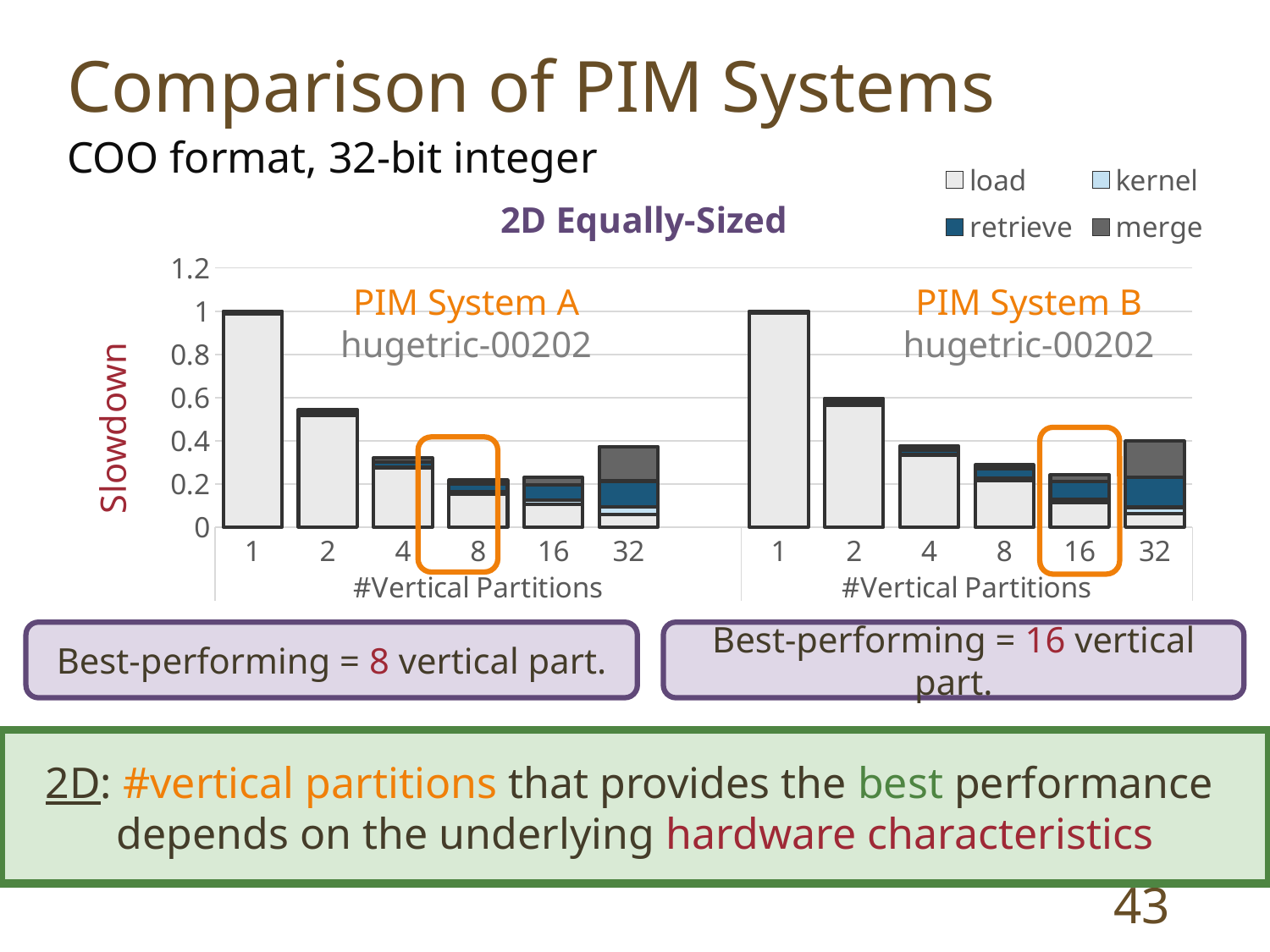
Which dataset name is shown on both charts? hugetric-00202 How many series does the legend list? 4 In the PIM System B chart, which number of vertical partitions is best-performing (lowest slowdown)? 16 In the PIM System B chart, which number of vertical partitions has the highest slowdown? 1 In the PIM System B chart, is the slowdown for 8 vertical partitions greater or less than 0.4? less What is the label of the y axis on the charts? Slowdown What kind of chart is used for PIM System A? bar chart In the PIM System A chart, what is the slowdown for 1 vertical partition? 1 In the PIM System A chart, is the slowdown for 2 vertical partitions greater or less than 0.4? greater In the PIM System A chart, how many #Vertical Partitions categories are shown on the x axis? 6 In the PIM System A chart, which has the larger slowdown: 2 vertical partitions or 4 vertical partitions? 2 In the PIM System A chart, which number of vertical partitions is best-performing (lowest slowdown)? 8